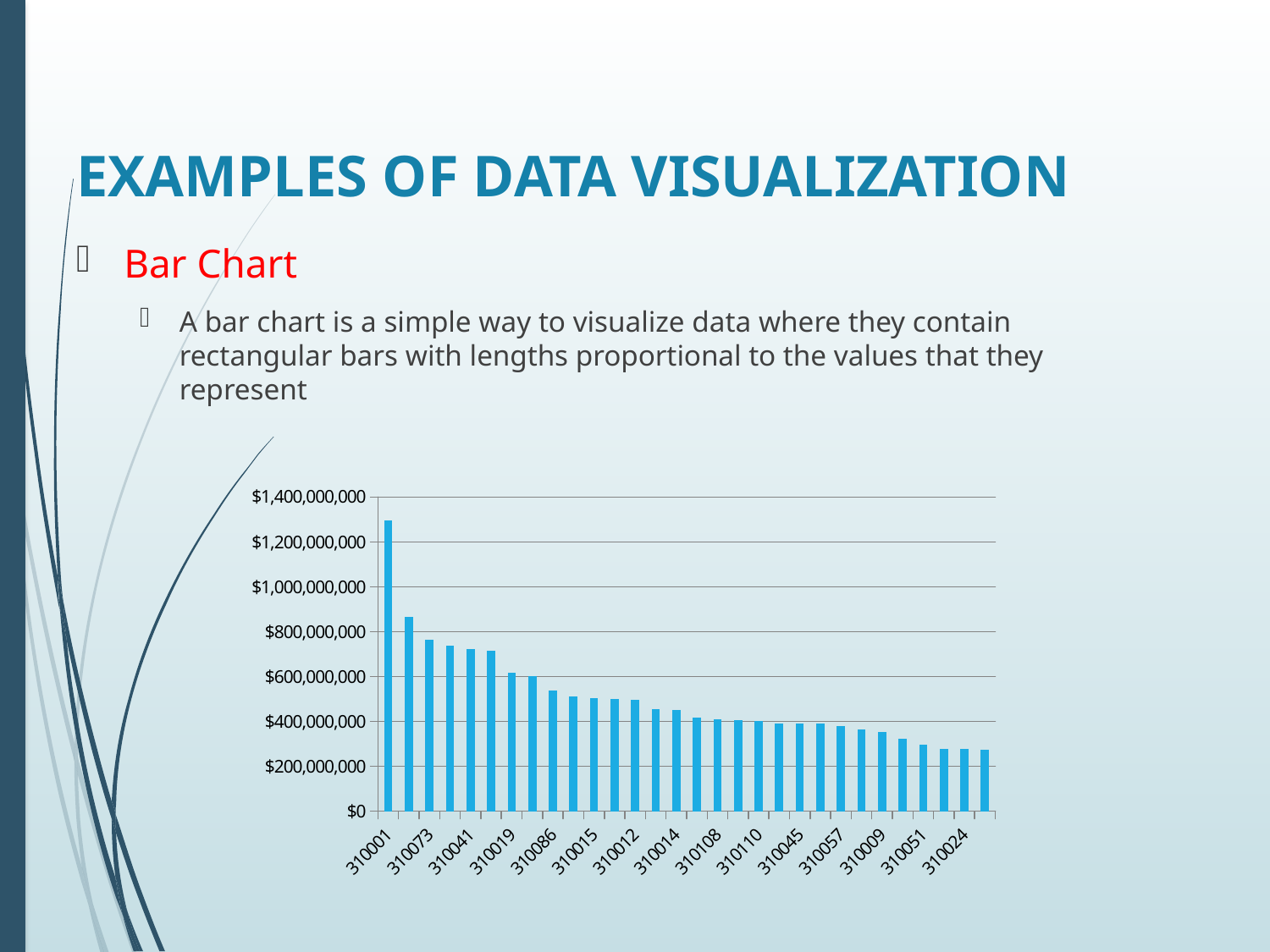
Is the value for 310009 greater or less than $400,000,000? less Do the bar values rise or fall from left to right along the x axis? fall Is the value for 310012 greater or less than $600,000,000? less Is the value for 310041 greater or less than $600,000,000? greater Which has the larger value, 310073 or 310024? 310073 What kind of chart is shown on the slide? bar chart What is the highest value shown on the y axis of the chart? $1,400,000,000 Which category has the highest value in the chart? 310001